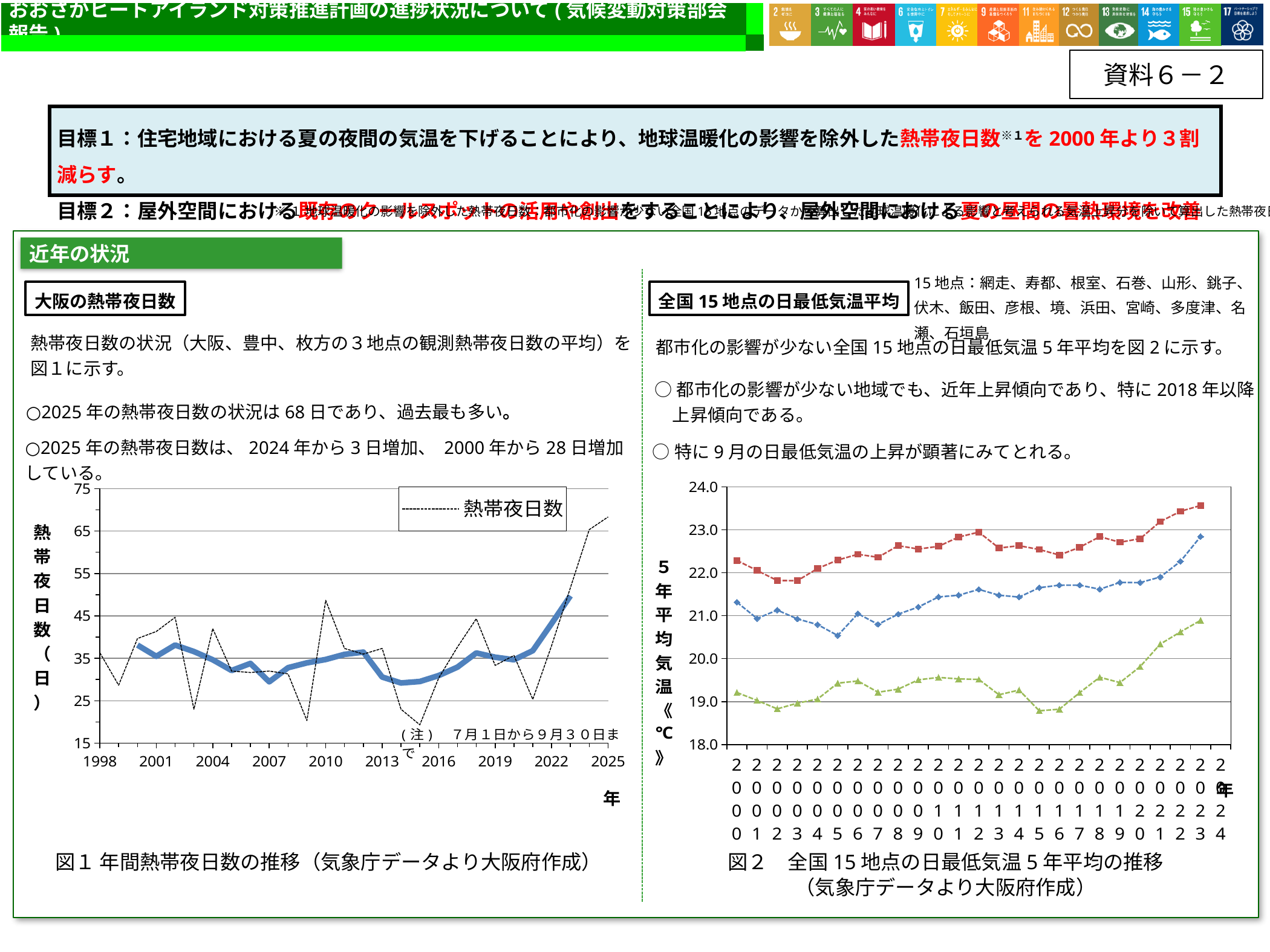
In the left chart (図1), which year has the larger dashed 熱帯夜日数 value, 2009 or 2010? 2010 What kind of chart is 図1 年間熱帯夜日数の推移 on the left? line chart In the left chart (図1), which year has the highest value on the dashed 熱帯夜日数 line? 2025 In the left chart (図1), is the dashed 熱帯夜日数 value for 2010 greater or less than 45? greater In the left chart (図1), how many series does the legend list? 1 In the right chart (図2), is the value of the green (bottom) line for 2015 greater or less than 19.0? less In the left chart (図1), is the dashed 熱帯夜日数 value for 2025 greater or less than 65? greater In the right chart (図2), how many years are shown on the x axis? 25 In the left chart (図1), what is the name of the series shown in the legend? 熱帯夜日数 In the right chart (図2), does the red (top) line rise or fall overall from 2000 to 2024? rise